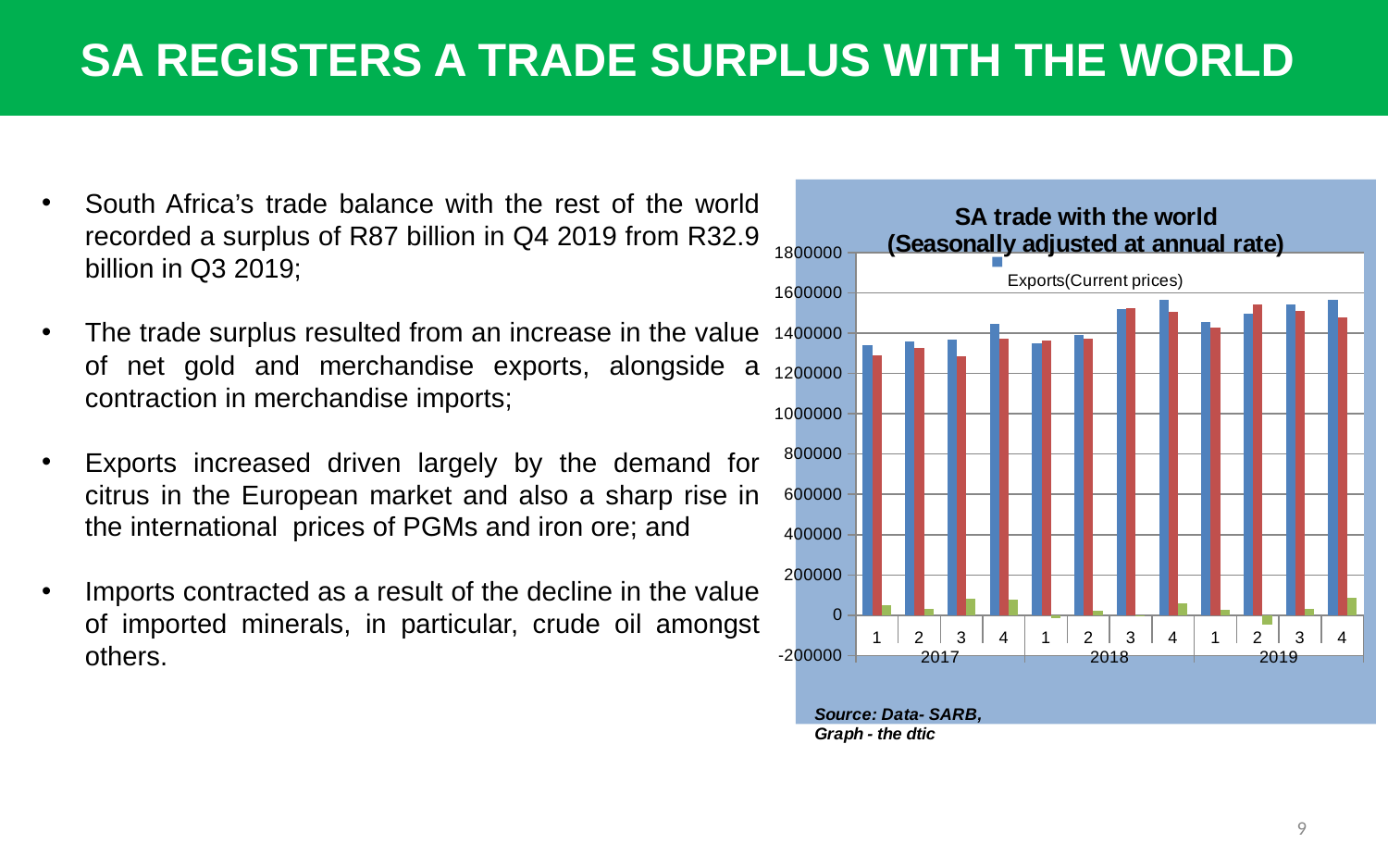
In quarter 2 of 2019, which is larger: the blue Exports(Current prices) bar or the red bar? the red bar Is the value of Exports(Current prices) for quarter 1 of 2017 greater or less than 1400000? less What kind of chart is shown on the slide? bar chart Which series is named in the chart's legend? Exports(Current prices) Is the value of Exports(Current prices) for quarter 4 of 2019 greater or less than 1400000? greater Is the value of the red series for quarter 3 of 2018 greater or less than 1400000? greater Which quarter has the lowest value for the green series? quarter 2 of 2019 What is the title of the chart? SA trade with the world (Seasonally adjusted at annual rate) In quarter 4 of 2019, which is larger: the blue Exports(Current prices) bar or the red bar? the blue Exports(Current prices) bar Do the Exports(Current prices) values generally rise or fall from quarter 1 of 2017 to quarter 4 of 2019? rise How many quarters (categories) are plotted along the x axis of the chart? 12